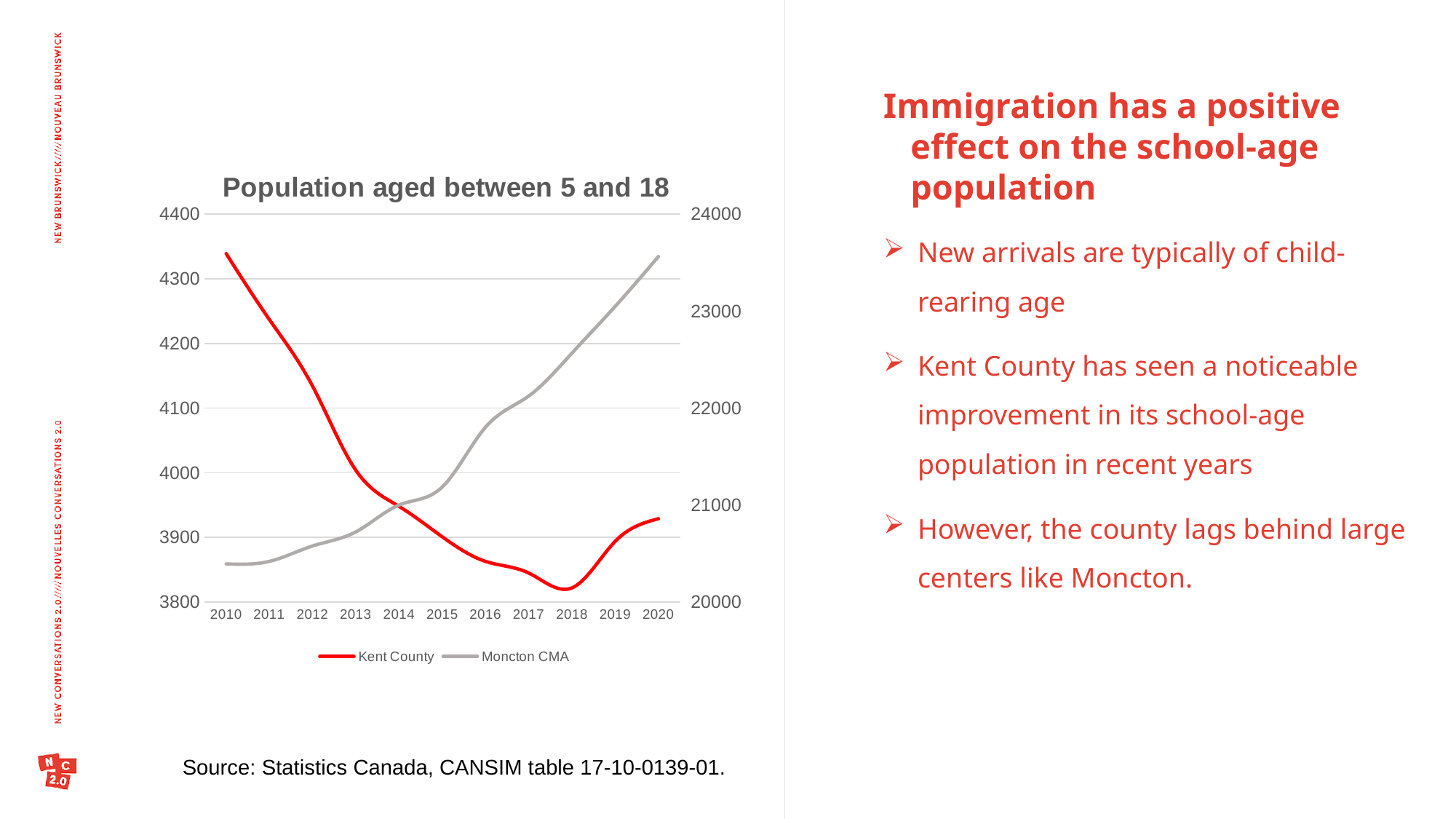
How many years are plotted along the x axis of the chart? 11 How many series does the chart's legend list? 2 What is the title of the chart? Population aged between 5 and 18 In which year is the Kent County value lowest? 2018 In which year is the Kent County value highest? 2010 Is the Moncton CMA value for 2020 greater or less than 23000? greater Is the Kent County value for 2018 greater or less than 3900? less Does the Moncton CMA line rise or fall from 2010 to 2020? rise Is the Kent County value for 2010 greater or less than 4300? greater What kind of chart is shown on the slide? line chart In which year is the Moncton CMA value highest? 2020 Which colour is used for the Kent County line? red